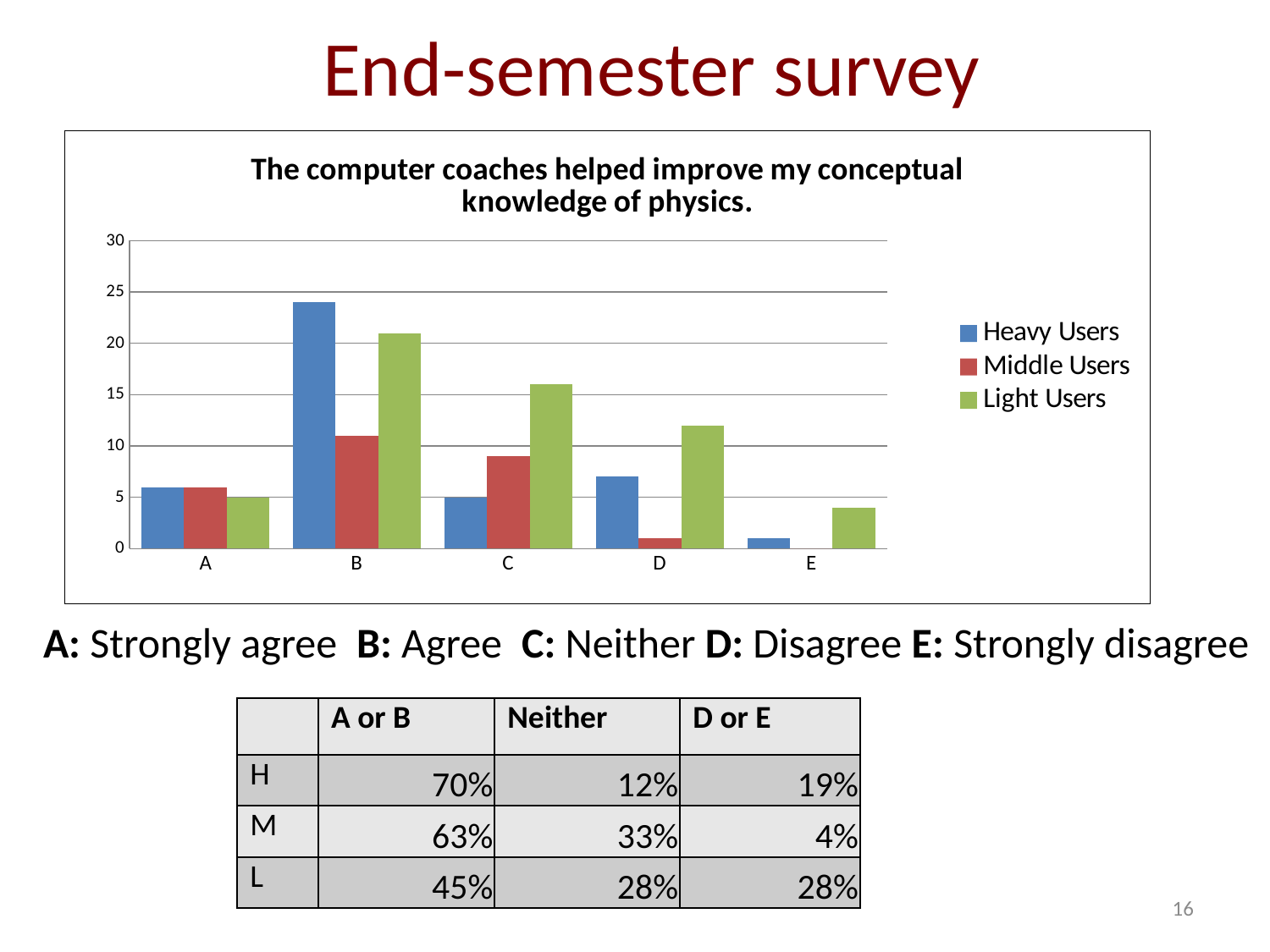
How many categories are shown on the x axis of the chart? 5 For Light Users, which category has the lowest bar? E What colour represents Light Users in the chart? green At category D, which is larger: Light Users or Heavy Users? Light Users What kind of chart is shown on the slide? bar chart Is the value for Middle Users at category B greater or less than 15? less How many series does the chart's legend list? 3 What is the title of the chart? The computer coaches helped improve my conceptual knowledge of physics. At category B, which is larger: Heavy Users or Light Users? Heavy Users Is the value for Light Users at category C greater or less than 10? greater For Heavy Users, which category has the highest bar? B Is the value for Heavy Users at category B greater or less than 20? greater